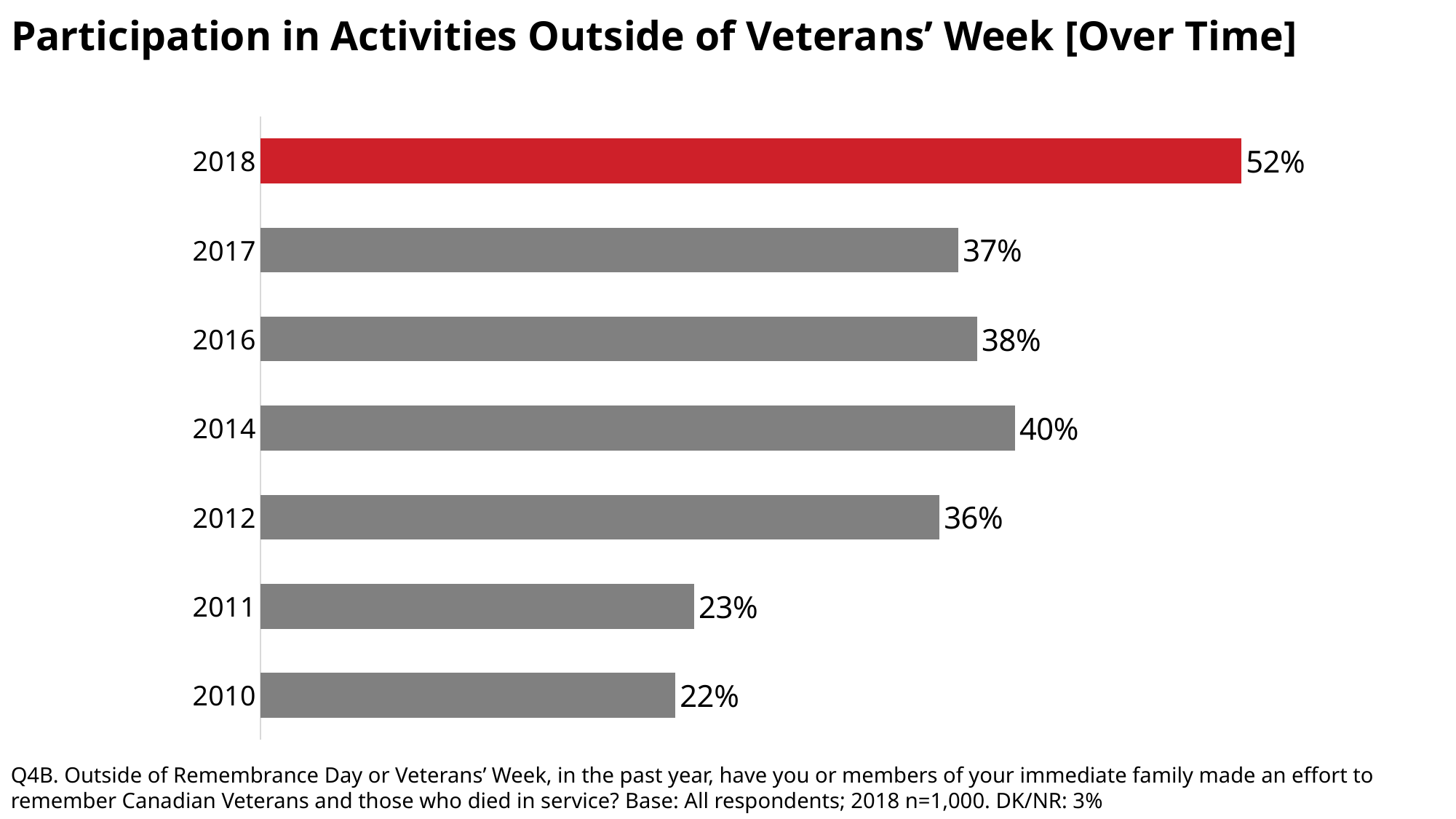
Which is larger, the value for 2016 or the value for 2012? 2016 What kind of chart is shown on the slide? Bar chart Which year's bar is coloured red? 2018 How many years are shown in the chart? 7 What is the value for 2010? 22% Which is larger, the value for 2011 or the value for 2014? 2014 What is the value for 2014? 40% What is the difference between the values for 2018 and 2017? 15% What is the difference between the values for 2014 and 2012? 4% Which year has the lowest value? 2010 Which year has the highest value? 2018 What is the value for 2018? 52%